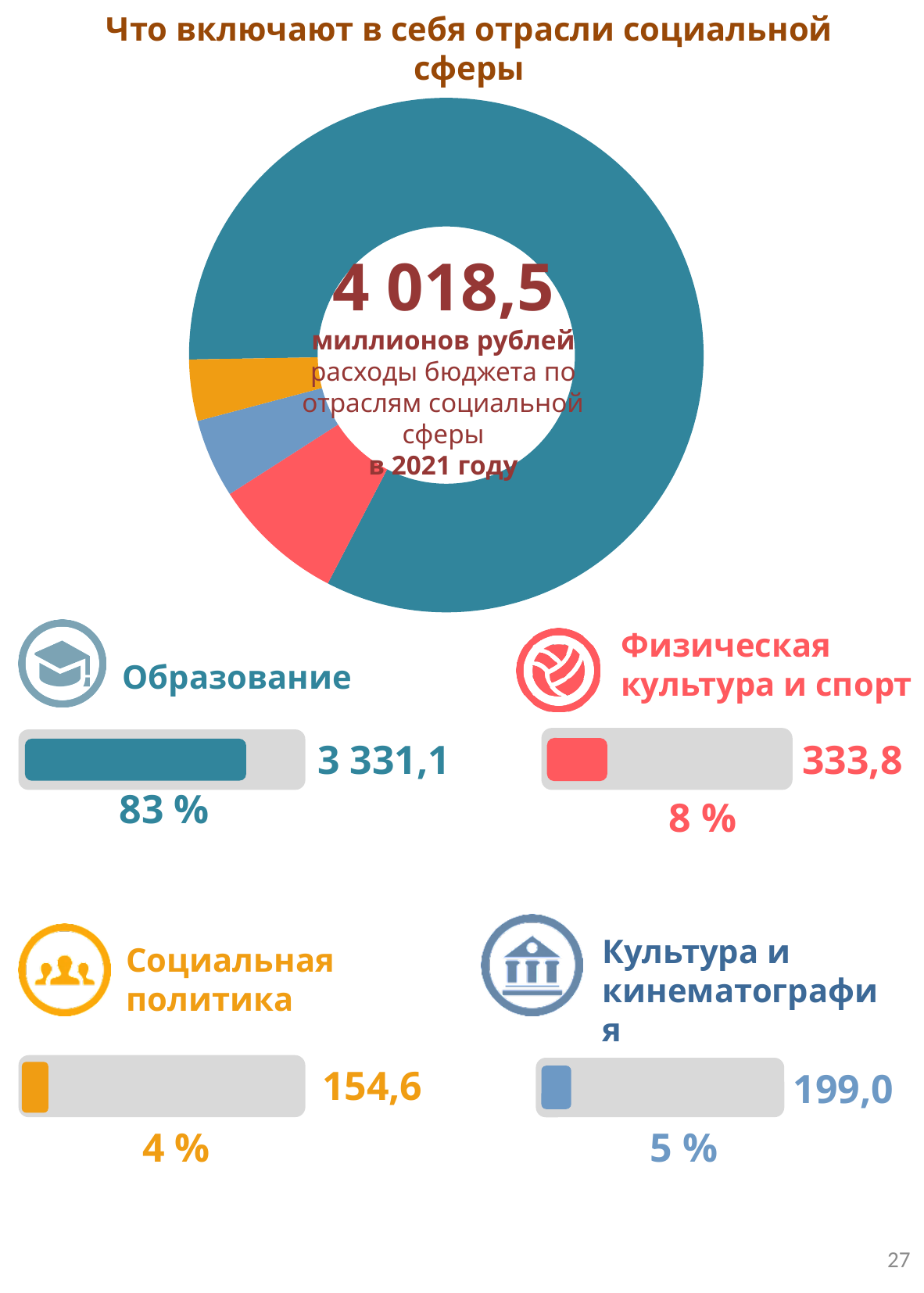
What is the value for Социальная политика? 154,6 Which category has the smallest share of the donut chart? Социальная политика What is the value for Образование? 3 331,1 What is the total value shown in the centre of the donut chart? 4 018,5 миллионов рублей What is the value for Культура и кинематография? 199,0 How many categories does the donut chart show? 4 What share of the total does Образование account for? 83 % What is the difference between the values for Физическая культура и спорт and Культура и кинематография? 134,8 Which category has the largest share of the donut chart? Образование What is the value for Физическая культура и спорт? 333,8 What share of the total does Культура и кинематография account for? 5 % Which is larger: the value for Культура и кинематография or the value for Социальная политика? Культура и кинематография